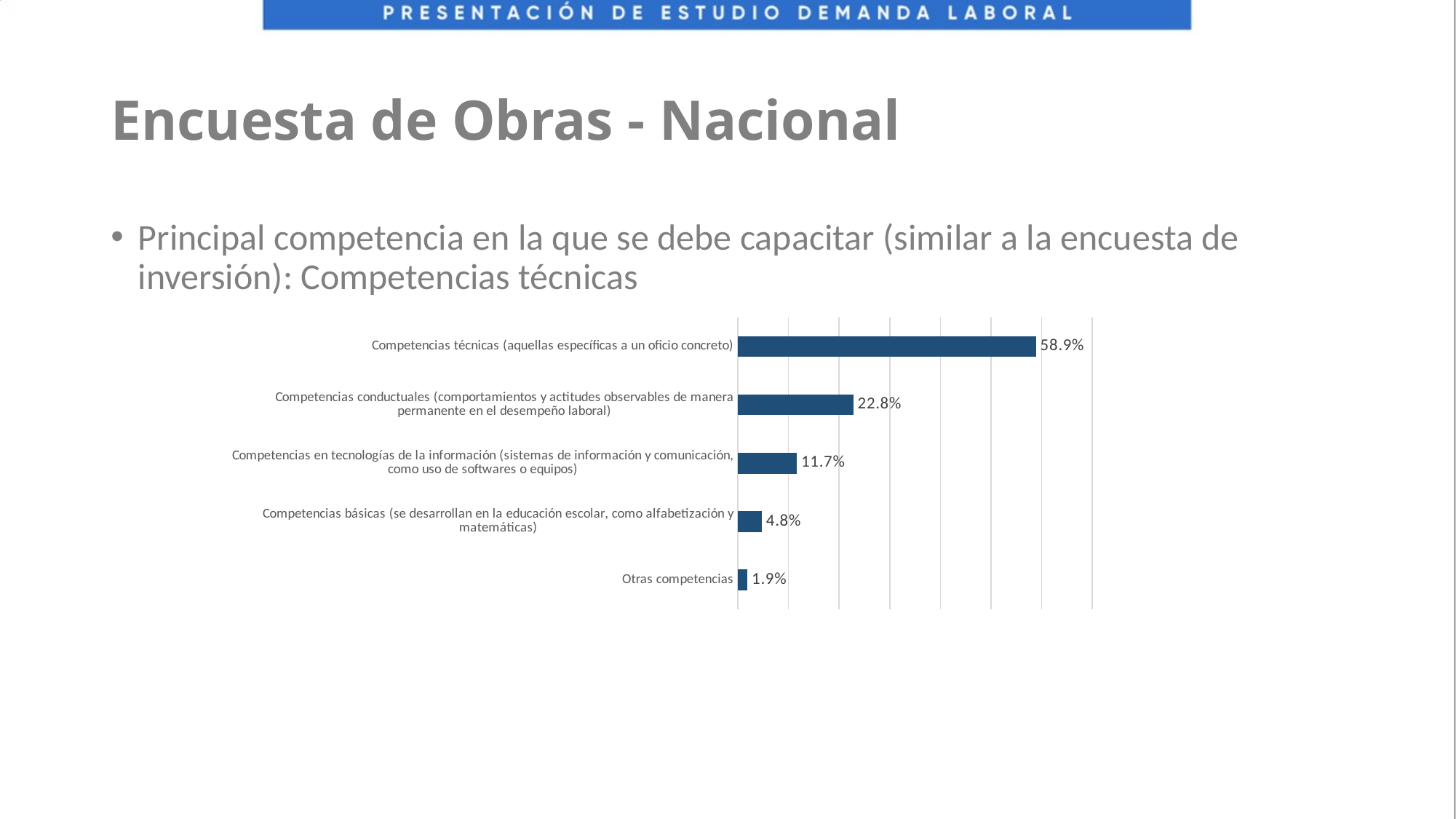
What is the value for Competencias técnicas (aquellas específicas a un oficio concreto)? 58.9% What is the value for Competencias en tecnologías de la información? 11.7% What kind of chart is shown on the slide? Bar chart Which category has the lowest value? Otras competencias What is the value for Competencias básicas? 4.8% Which category has the highest value? Competencias técnicas (aquellas específicas a un oficio concreto) What is the difference between the values for Competencias técnicas and Competencias conductuales? 36.1% How many categories are shown in the chart? 5 What is the value for Competencias conductuales? 22.8% What is the difference between the values for Competencias en tecnologías de la información and Competencias básicas? 6.9% What is the value for Otras competencias? 1.9% Which is larger, the value for Competencias conductuales or the value for Competencias en tecnologías de la información? Competencias conductuales